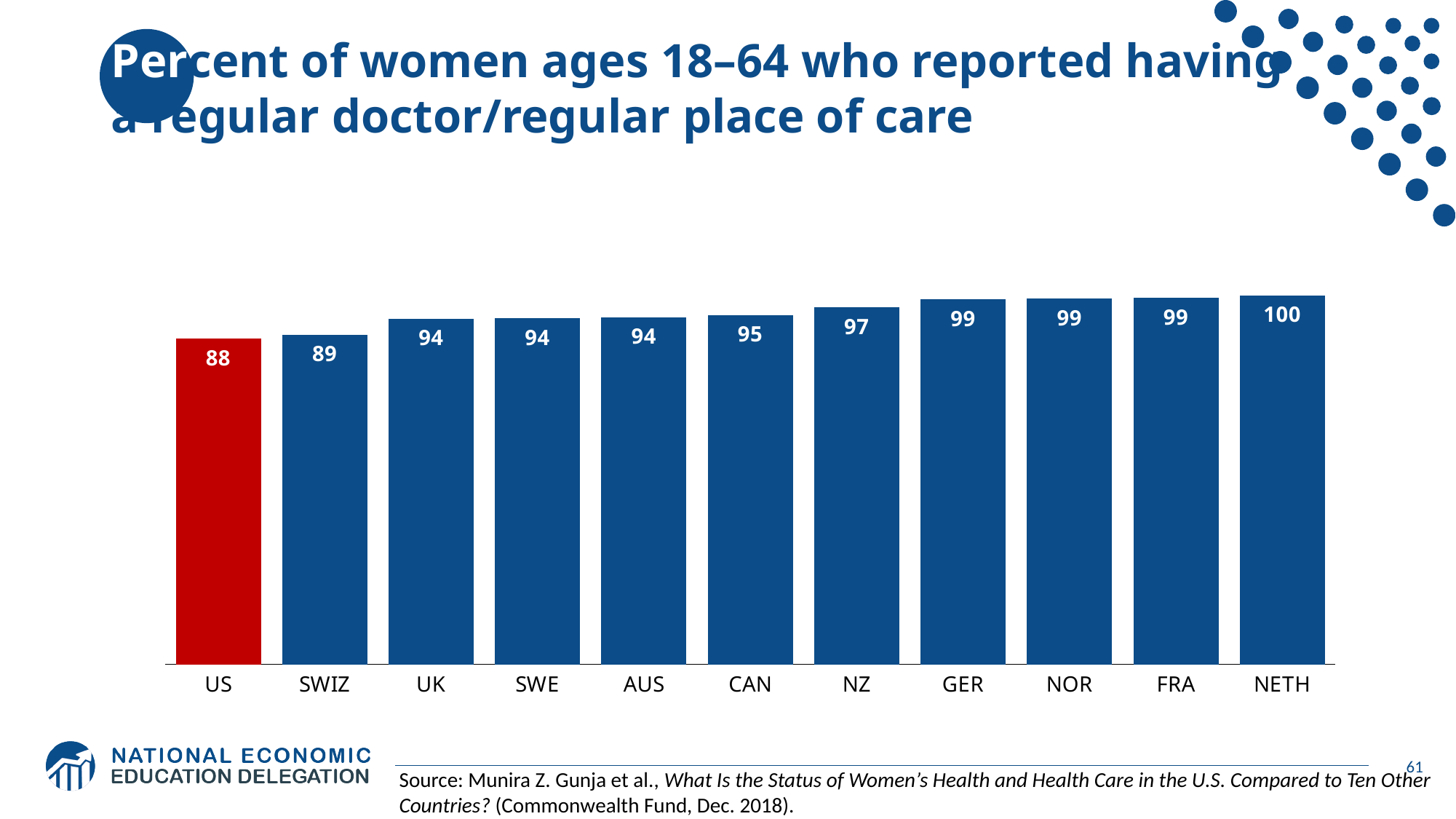
What is the difference between the values for NETH and the US? 12 Which is larger, the value for UK or the value for NZ? NZ What kind of chart is shown on the slide? bar chart Do the values rise or fall from left to right along the x axis? rise What is the value for the US? 88 What is the value for CAN? 95 How many countries are shown on the chart? 11 Which country has the lowest value? US Which country has the highest value? NETH Which bar is coloured red? US What is the value for NZ? 97 What is the difference between the values for SWIZ and the US? 1